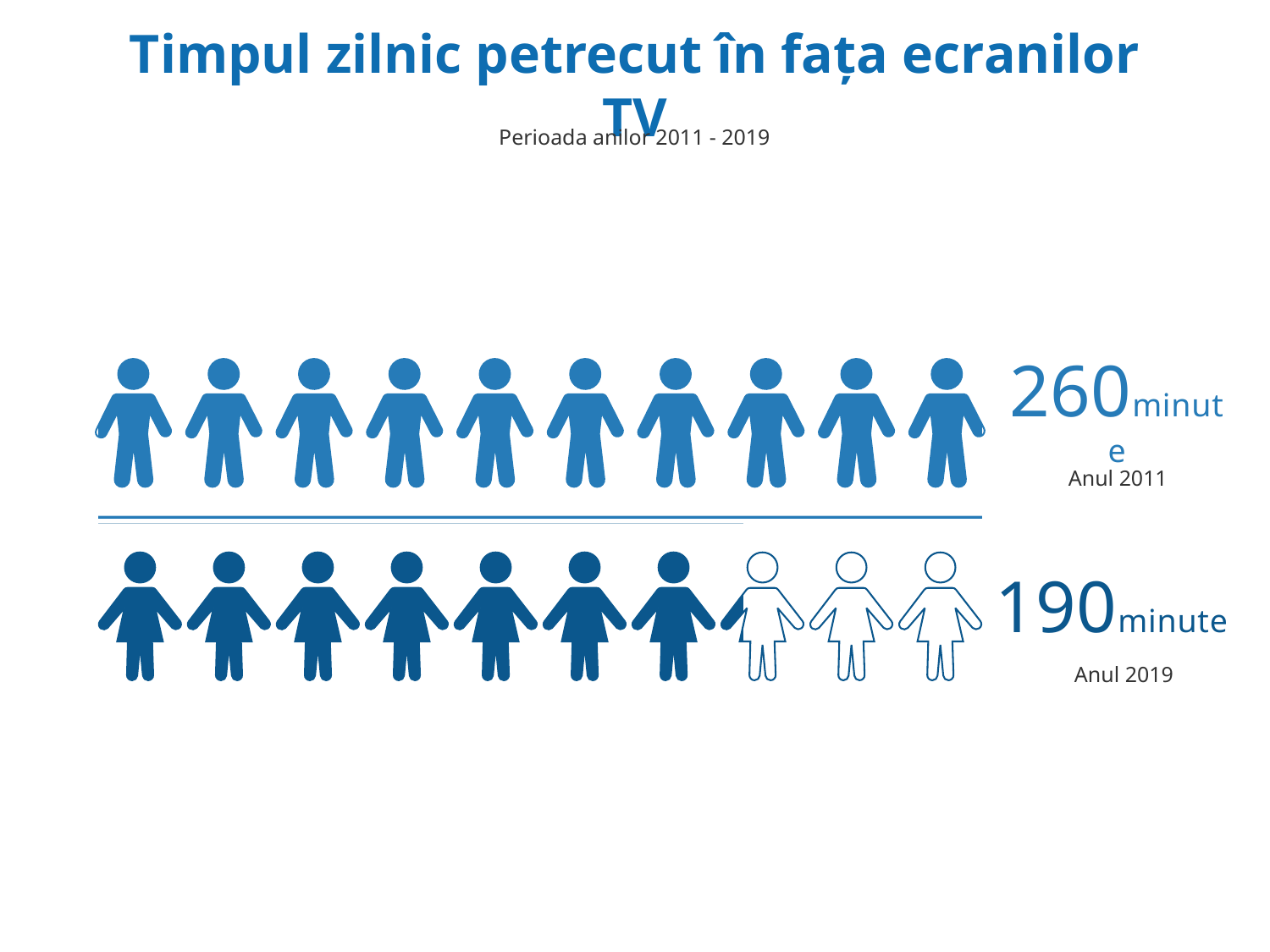
Which year shows the lowest daily screen time? Anul 2019 How many person icons are outlined (unfilled) in the row for Anul 2019? 3 Which year has the higher daily screen time, 2011 or 2019? 2011 By how many minutes did daily screen time decrease from 2011 to 2019? 70 minute What kind of chart is shown on the slide? pictograph (icon chart) How many person icons are shown in the row for Anul 2011? 10 How many person icons are filled in the row for Anul 2019? 7 What is the daily screen time value shown for Anul 2019? 190 minute What is the daily screen time value shown for Anul 2011? 260 minute Does daily screen time rise or fall from 2011 to 2019? fall What period is stated in the subtitle of the chart? Perioada anilor 2011 - 2019